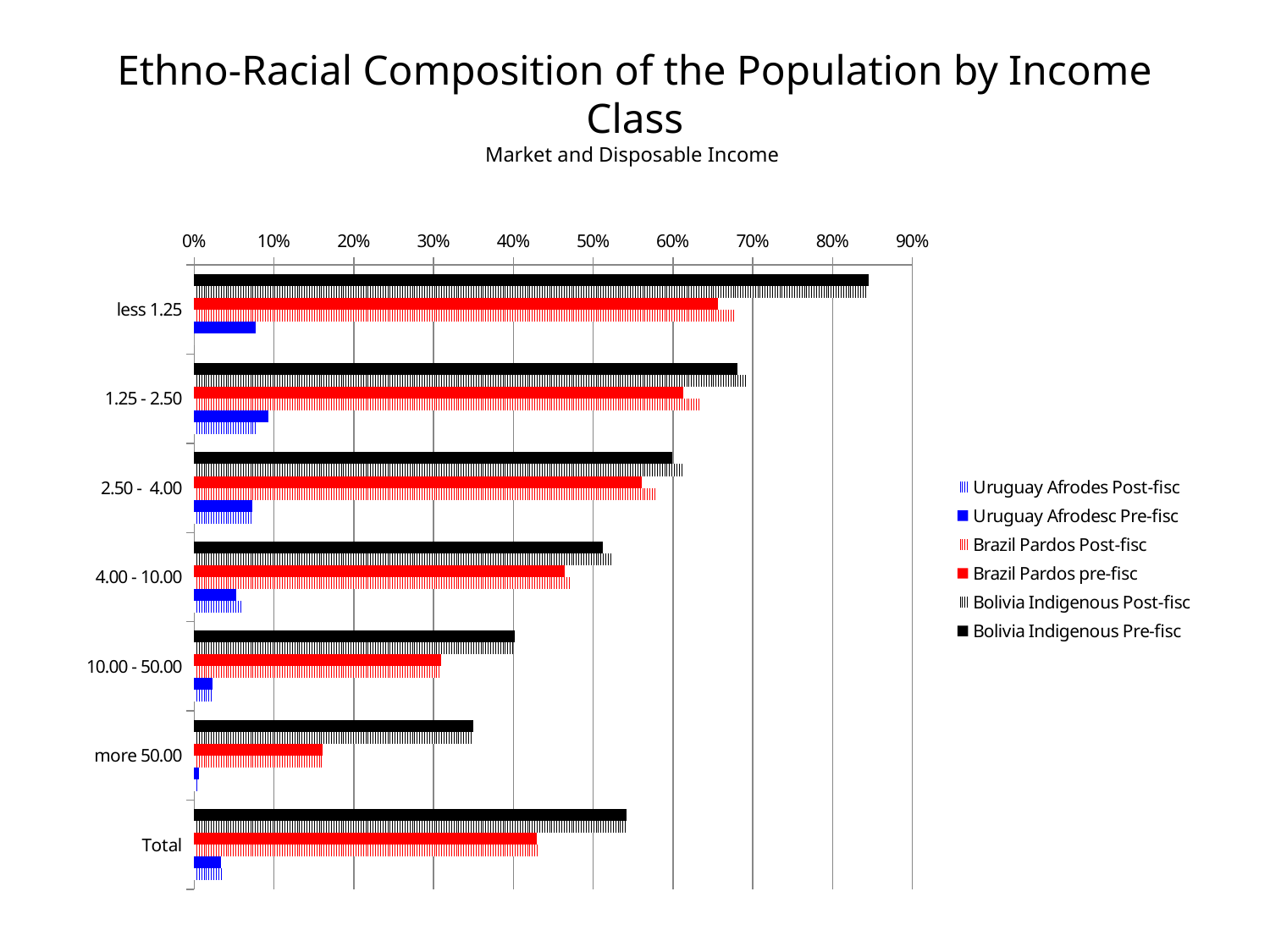
Is the value for Uruguay Afrodesc Pre-fisc in the less 1.25 class greater or less than 10%? less Is the value for Bolivia Indigenous Pre-fisc in the less 1.25 class greater or less than 80%? greater Do the values for Bolivia Indigenous Pre-fisc rise or fall as the income class increases from less 1.25 to more 50.00? fall Which income class has the lowest value for Brazil Pardos pre-fisc? more 50.00 What kind of chart is shown on the slide? bar chart What is the subtitle shown under the chart title? Market and Disposable Income Which income class has the highest value for Bolivia Indigenous Pre-fisc? less 1.25 How many income class categories are shown on the vertical axis? 7 How many series does the legend list? 6 In the 10.00 - 50.00 class, which is larger: Bolivia Indigenous Pre-fisc or Brazil Pardos pre-fisc? Bolivia Indigenous Pre-fisc Is the value for Bolivia Indigenous Pre-fisc in the Total category greater or less than 50%? greater